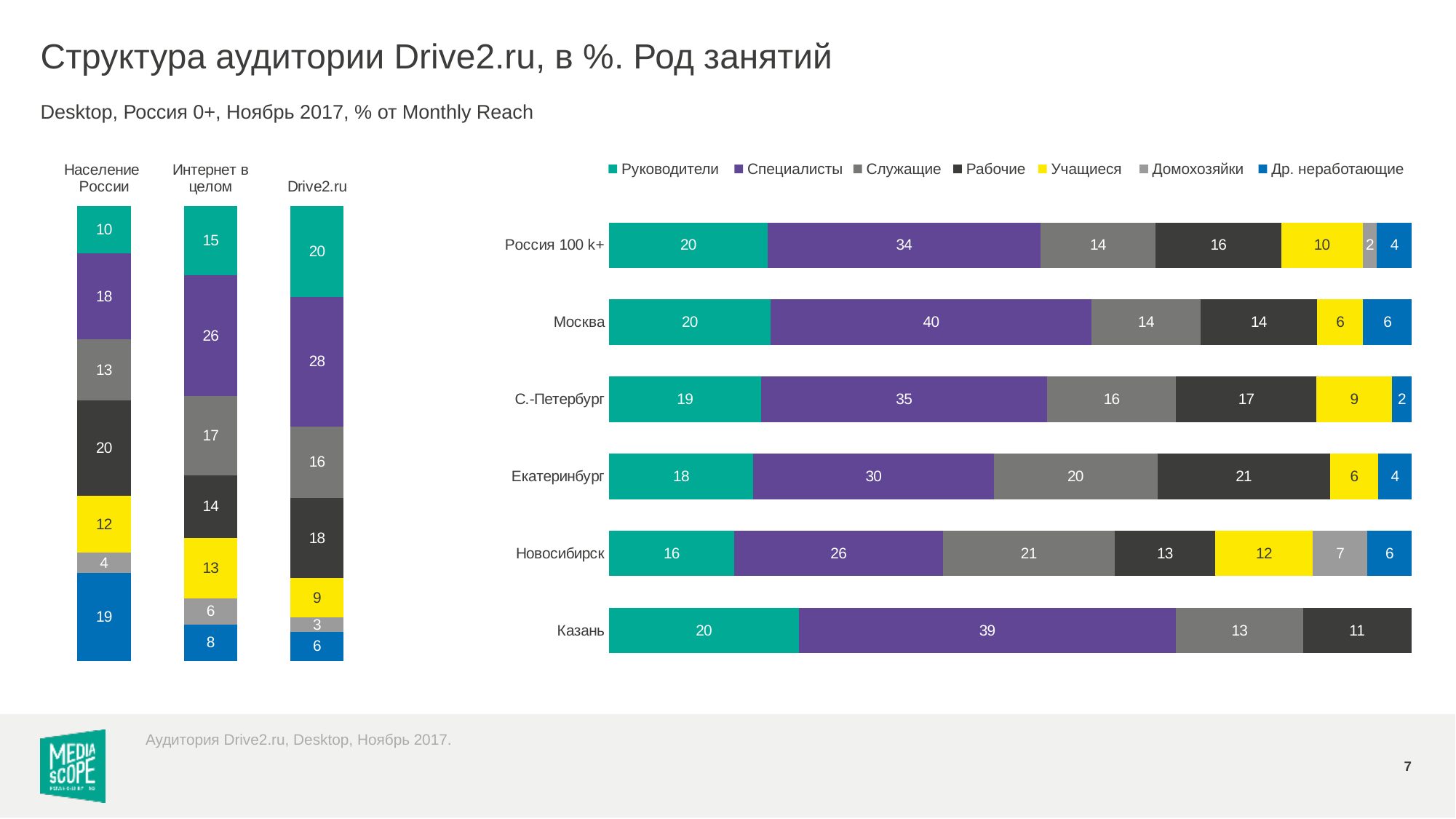
What kind of chart is the right chart? Stacked bar chart In the left chart, what is the value for Специалисты in the Drive2.ru bar? 28 In the right chart, what is the value for Учащиеся for Новосибирск? 12 In the right chart, what is the value for Специалисты for Москва? 40 In the left chart, which is larger: the Др. неработающие value for Население России or for Drive2.ru? Население России In the right chart, which city has the highest value for Специалисты? Москва In the right chart, which city has the lowest value for Руководители? Новосибирск How many city/region categories are shown in the right chart? 6 How many series does the legend list? 7 In the left chart, what is the total of the Drive2.ru stacked bar? 100 In the right chart, what is the difference between the Специалисты values for Казань and Екатеринбург? 9 In the left chart, what is the value for Рабочие in the Население России bar? 20